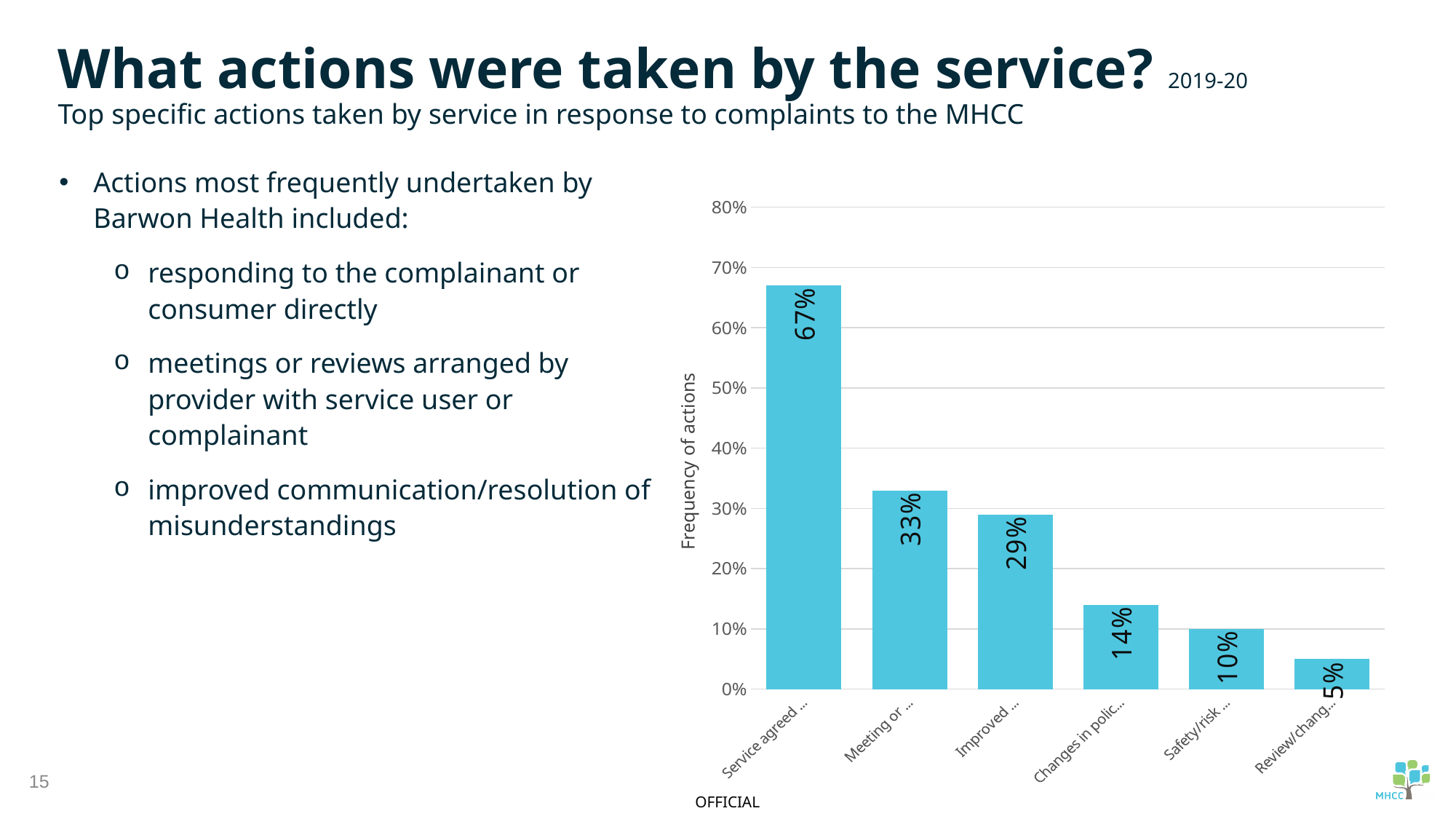
Which category has the highest frequency of actions? Service agreed ... How many bars (categories) are plotted in the chart? 6 What is the difference between the values for "Meeting or ..." and "Improved ..."? 4% What is the label of the vertical axis of the chart? Frequency of actions Which category has the lowest frequency of actions? Review/chang... What is the value of the bar labelled "Changes in polic..."? 14% What type of chart is shown on the slide? bar chart Which is larger, the value for "Changes in polic..." or the value for "Safety/risk ..."? Changes in polic... What is the value of the bar labelled "Service agreed ..."? 67% What is the value of the bar labelled "Review/chang..."? 5% What is the value of the bar labelled "Meeting or ..."? 33% Do the bar values rise or fall from left to right along the x axis? fall